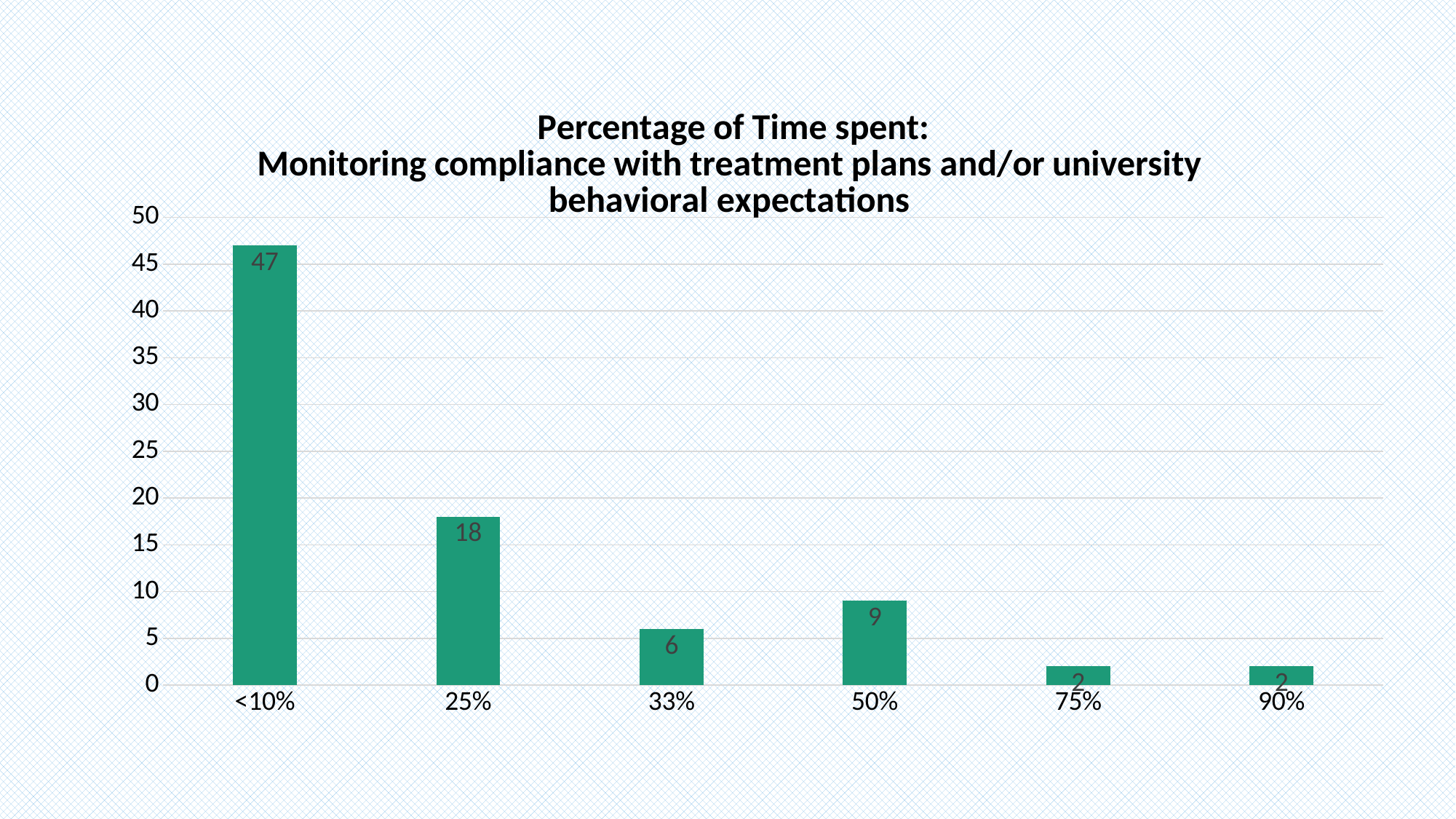
What is the difference between the values for <10% and 25%? 29 What kind of chart is shown on the slide? bar chart What is the value for the 25% category? 18 How many categories are shown on the x axis? 6 Which is larger, the value for 33% or the value for 50%? 50% What is the title of the chart? Percentage of Time spent: Monitoring compliance with treatment plans and/or university behavioral expectations What is the difference between the values for 50% and 33%? 3 What is the value for the 33% category? 6 Is the value for <10% greater or less than 40? greater Which category has the highest value? <10% What is the value for the 50% category? 9 What is the value for the <10% category? 47